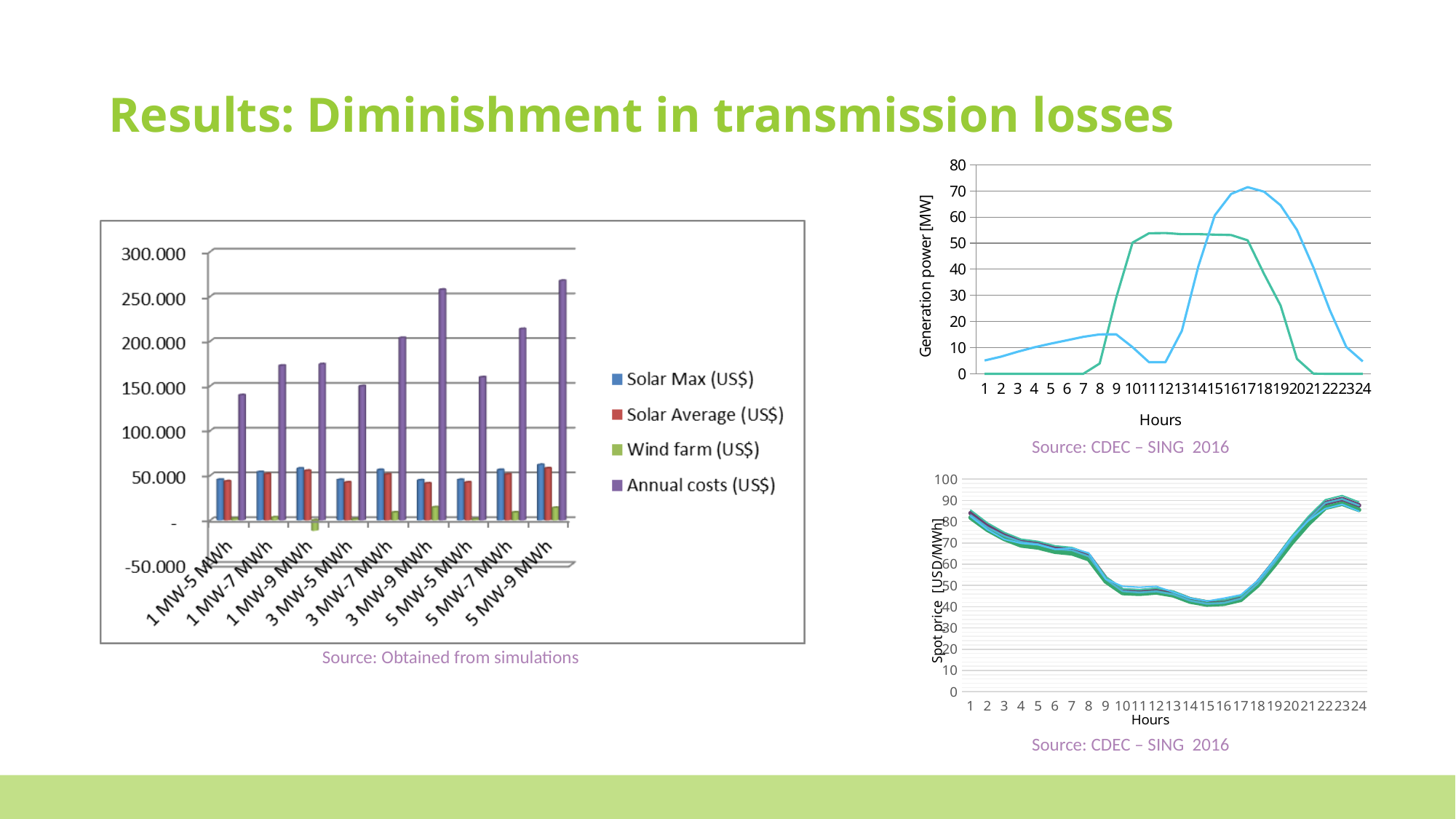
In the left bar chart, which series has the only bar that goes below zero? Wind farm (US$) What kind of chart is the chart on the left of the slide? bar chart What kind of chart is the top-right chart with the y axis 'Generation power [MW]'? line chart In the left bar chart, which series is larger for 5 MW-7 MWh: Annual costs (US$) or Solar Max (US$)? Annual costs (US$) How many series does the legend of the left bar chart list? 4 How many categories are shown on the x axis of the left bar chart? 9 In the left bar chart, is the Annual costs (US$) value for 3 MW-9 MWh greater or less than 250.000? greater In the top-right Generation power chart, is the peak value of the blue line at hour 17 greater or less than 60? greater In the bottom-right Spot price chart, is the value at hour 15 greater or less than 50? less In the bottom-right Spot price chart, do the values rise or fall from hour 1 to hour 15? fall In the top-right Generation power chart, what is the value of the green line at hour 3? 0